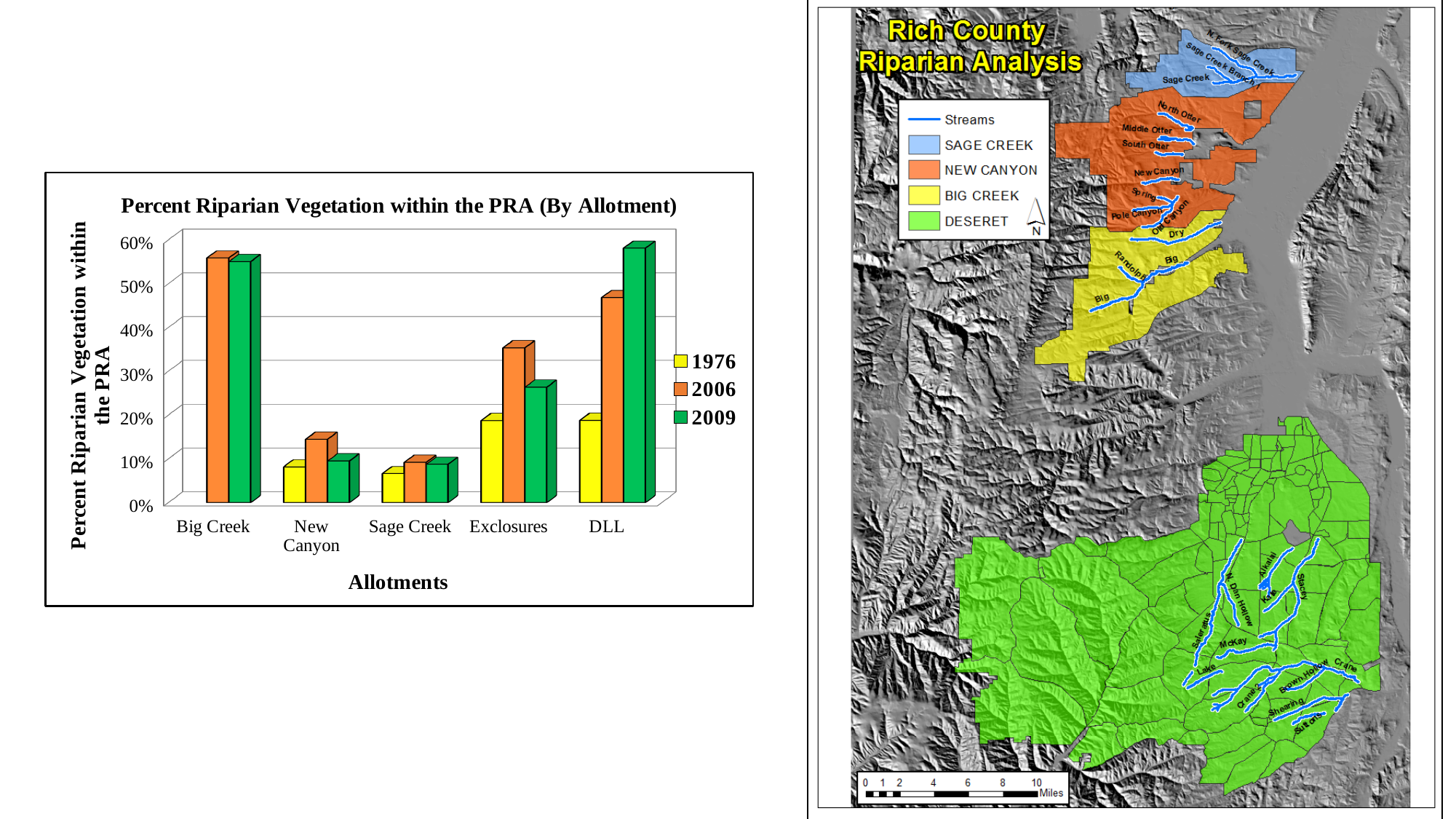
Is the 2009 value for DLL greater or less than 50%? greater For Exclosures, which year has the larger value, 2006 or 2009? 2006 Which allotment has the highest 2009 value? DLL What is the title of the chart? Percent Riparian Vegetation within the PRA (By Allotment) How many allotments are shown on the x axis of the chart? 5 What kind of chart is shown on the slide? bar chart Do the values for DLL rise or fall from 1976 to 2009? rise Is the 2006 value for Exclosures greater or less than 30%? greater Which allotment has the lowest 2006 value? Sage Creek For DLL, which year has the larger value, 2006 or 2009? 2009 Is the 1976 value for New Canyon greater or less than 10%? less How many series does the chart legend list? 3